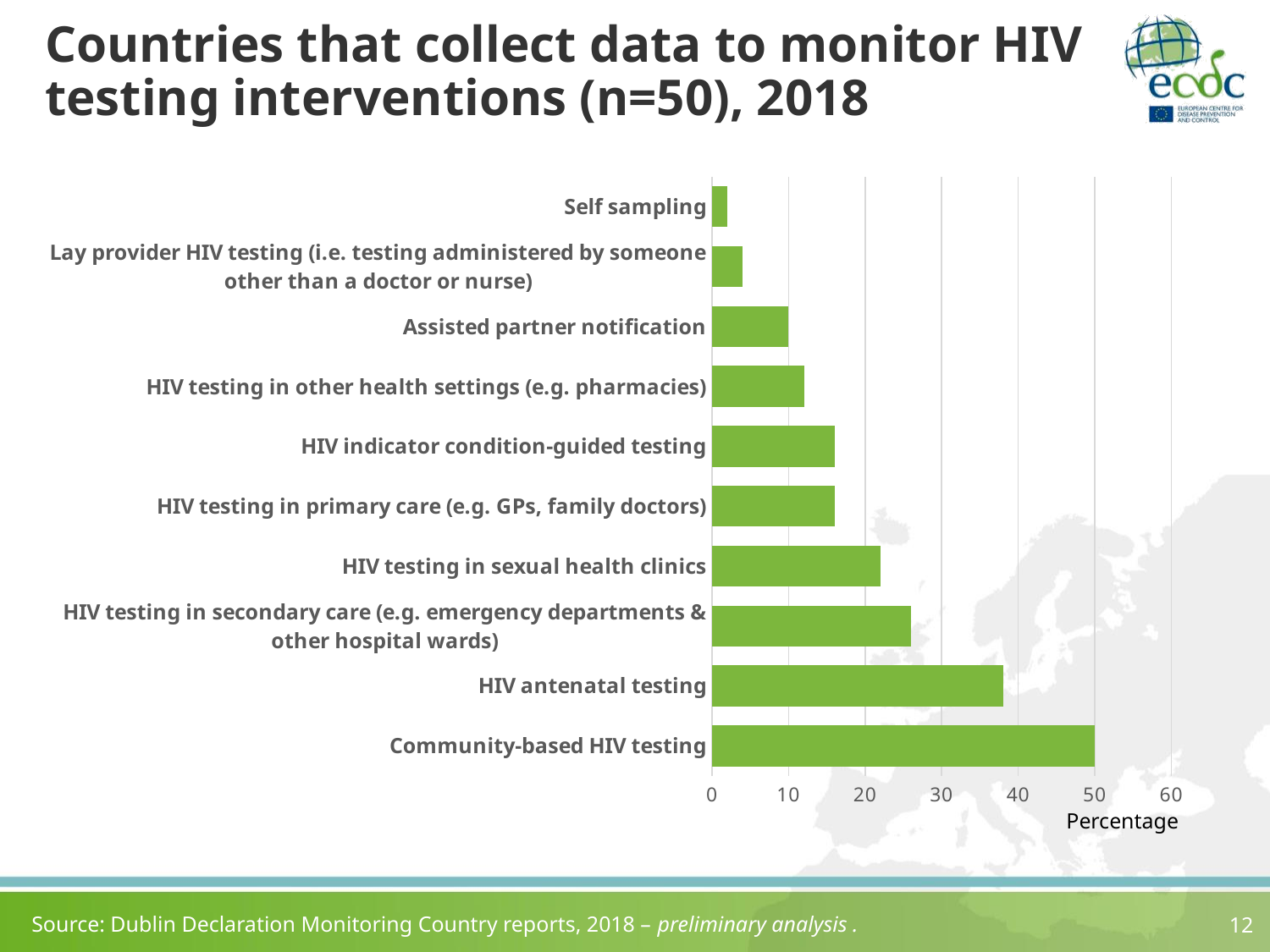
Which testing intervention has the lowest percentage of countries collecting data? Self sampling Which has a larger value: Assisted partner notification or Lay provider HIV testing (i.e. testing administered by someone other than a doctor or nurse)? Assisted partner notification Is the value for Self sampling greater or less than 10? less Is the value for HIV testing in sexual health clinics greater or less than 30? less Is the value for HIV testing in secondary care (e.g. emergency departments & other hospital wards) greater or less than 20? greater What is the label on the horizontal axis of the chart? Percentage Which has a larger value: HIV antenatal testing or HIV testing in sexual health clinics? HIV antenatal testing How many categories (testing interventions) are plotted in the chart? 10 Which testing intervention has the highest percentage of countries collecting data? Community-based HIV testing What percentage of countries collect data on Community-based HIV testing? 50 What kind of chart is shown on the slide? bar chart